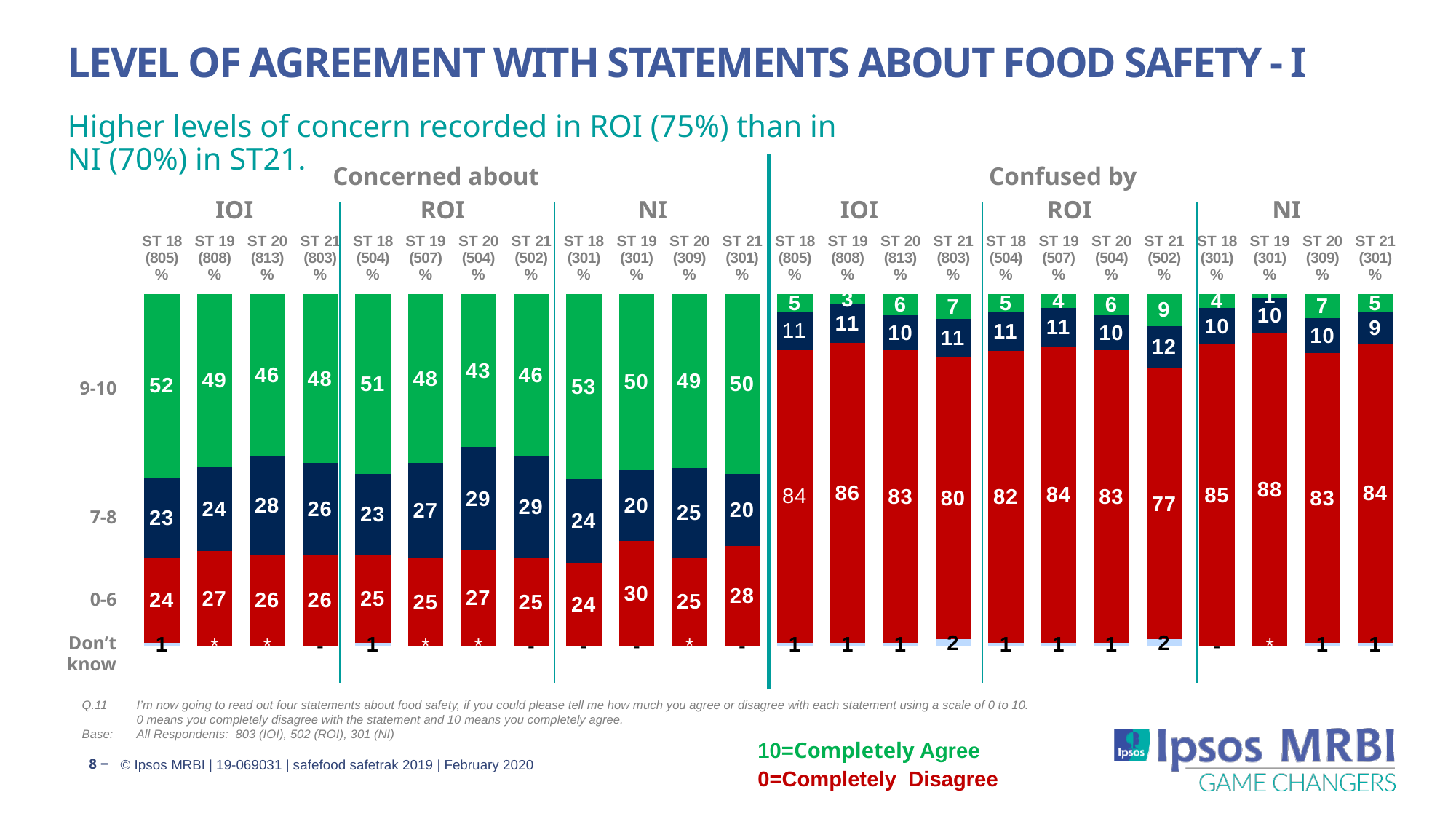
In the 'Concerned about' panel, how much higher is the IOI 9-10 value in ST 18 than in ST 21? 4 What type of chart is used on this slide? Stacked bar chart What is the total of the segments for the IOI ST 18 bar in the 'Concerned about' panel (52 + 23 + 24 + 1)? 100 In the 'Confused by' panel, is the 0-6 value for IOI in ST 21 greater or less than 90? less In the 'Confused by' panel, what percentage of NI respondents in ST 19 gave a 0-6 rating? 88 In the 'Confused by' panel, which ROI wave has the lowest 0-6 value? ST 21 In the 'Concerned about' panel, which is larger for ST 19: the 0-6 value for NI or the 0-6 value for ROI? NI In the 'Concerned about' panel, what is the 7-8 value for ROI in ST 20? 29 How many response bands are labelled on the left of the chart (9-10, 7-8, 0-6, Don't know)? 4 In the 'Concerned about' panel, what percentage of IOI respondents in ST 18 gave a 9-10 rating? 52 How many bars are shown in the 'Concerned about' panel? 12 In the 'Concerned about' panel, which NI wave has the highest 9-10 value? ST 18